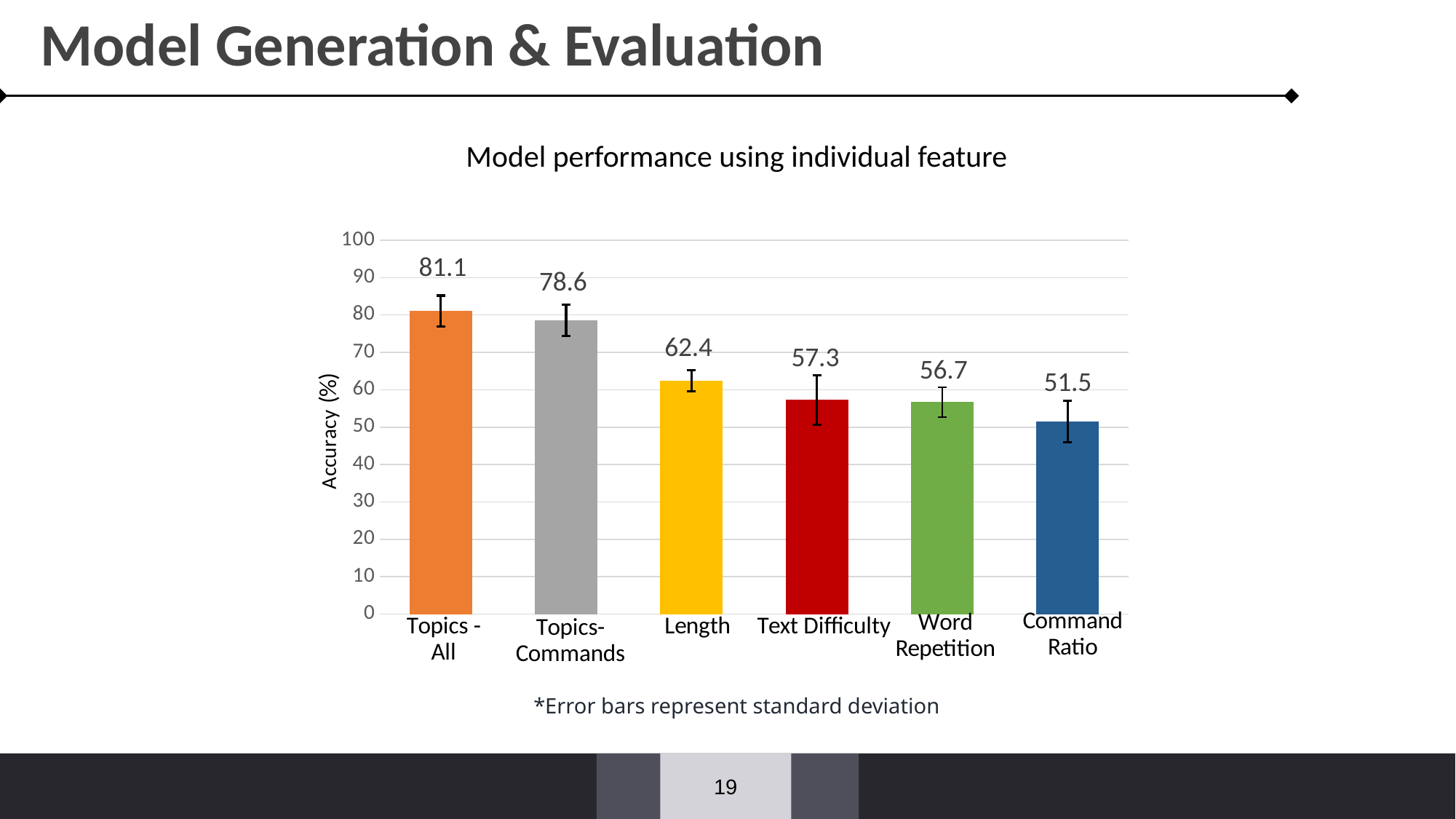
Which feature has the lowest accuracy? Command Ratio What kind of chart is shown on the slide? Bar chart What is the difference in accuracy between Topics - All and Topics-Commands? 2.5 What is the accuracy for Command Ratio? 51.5 What is the title of the chart? Model performance using individual feature Which feature has the highest accuracy? Topics - All What is the difference in accuracy between Length and Command Ratio? 10.9 Which has a higher accuracy, Text Difficulty or Word Repetition? Text Difficulty What is the accuracy for Topics - All? 81.1 What is the accuracy for Length? 62.4 How many features are shown in the chart? 6 Do the accuracy values rise or fall from left to right across the features? Fall